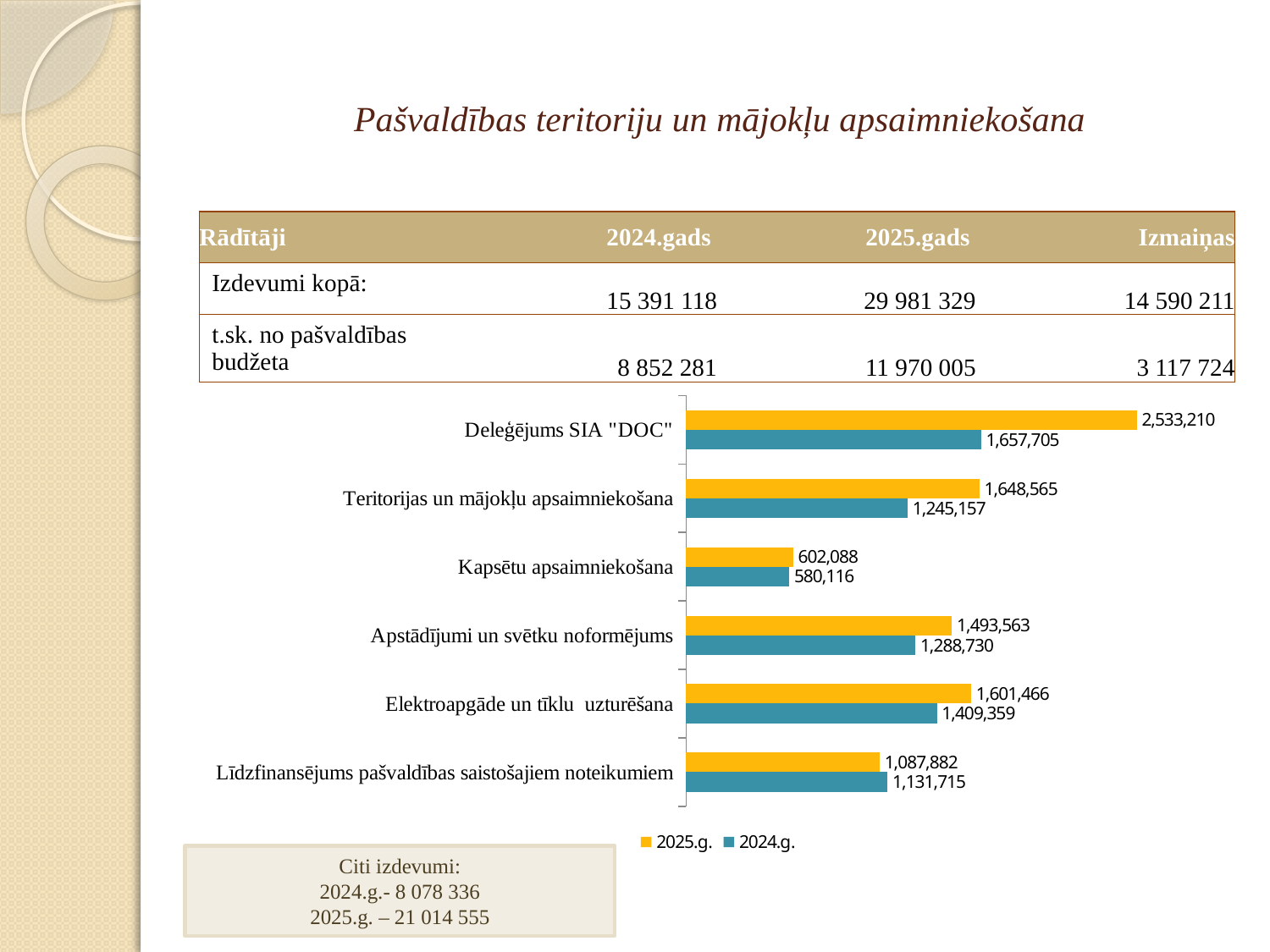
What is the 2025.g. value for Deleģējums SIA "DOC"? 2,533,210 Which category has the lowest 2024.g. value? Kapsētu apsaimniekošana What type of chart is shown on the slide? Bar chart What is the 2025.g. value for Kapsētu apsaimniekošana? 602,088 How many series does the chart legend list? 2 For Līdzfinansējums pašvaldības saistošajiem noteikumiem, which is larger: the 2024.g. value or the 2025.g. value? 2024.g. What is the 2024.g. value for Elektroapgāde un tīklu uzturēšana? 1,409,359 Which category has the highest 2025.g. value? Deleģējums SIA "DOC" What is the 2024.g. value for Līdzfinansējums pašvaldības saistošajiem noteikumiem? 1,131,715 How many categories are shown in the bar chart? 6 What is the difference between the 2025.g. and 2024.g. values for Deleģējums SIA "DOC"? 875,505 What is the difference between the 2024.g. and 2025.g. values for Līdzfinansējums pašvaldības saistošajiem noteikumiem? 43,833